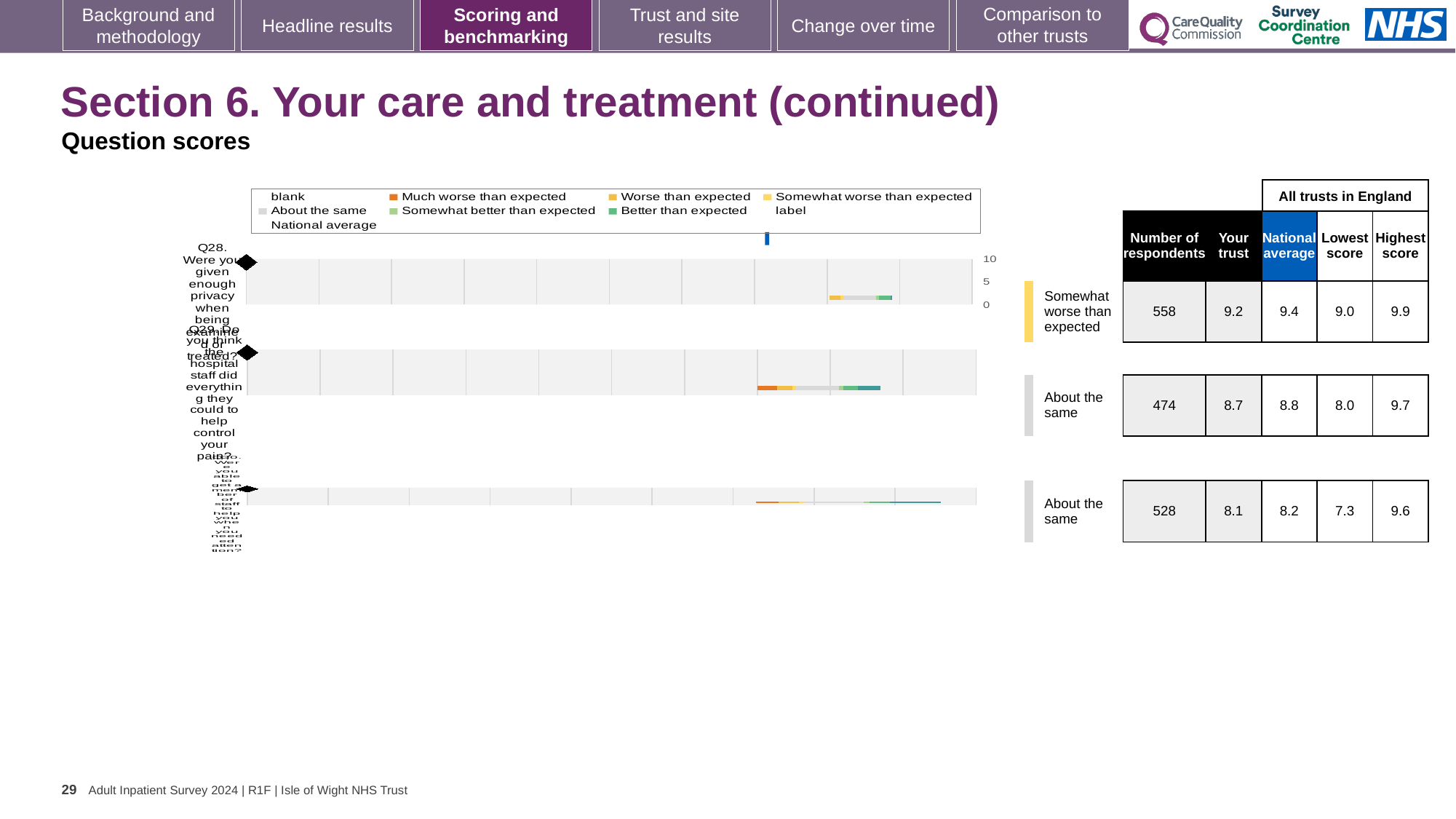
Which question has the highest 'Highest score' value in the table? Q28 What is the national average for the third question row (Q30)? 8.2 How many survey questions are plotted in the chart? 3 How many entries does the chart legend list? 9 What is the difference between the national average and the 'Your trust' score for Q28? 0.2 Which question has the lowest 'Lowest score' value in the table? Q30 Which has the higher 'Your trust' score, Q28 or Q29? Q28 What is the 'Your trust' score for Q28 (Were you given enough privacy when being examined or treated?)? 9.2 What benchmark category is shown for Q29? About the same What kind of chart is used to show the question scores on this slide? bar chart How many respondents are shown for Q29 (Do you think the hospital staff did everything they could to help control your pain?)? 474 What benchmark category is shown for Q28? Somewhat worse than expected